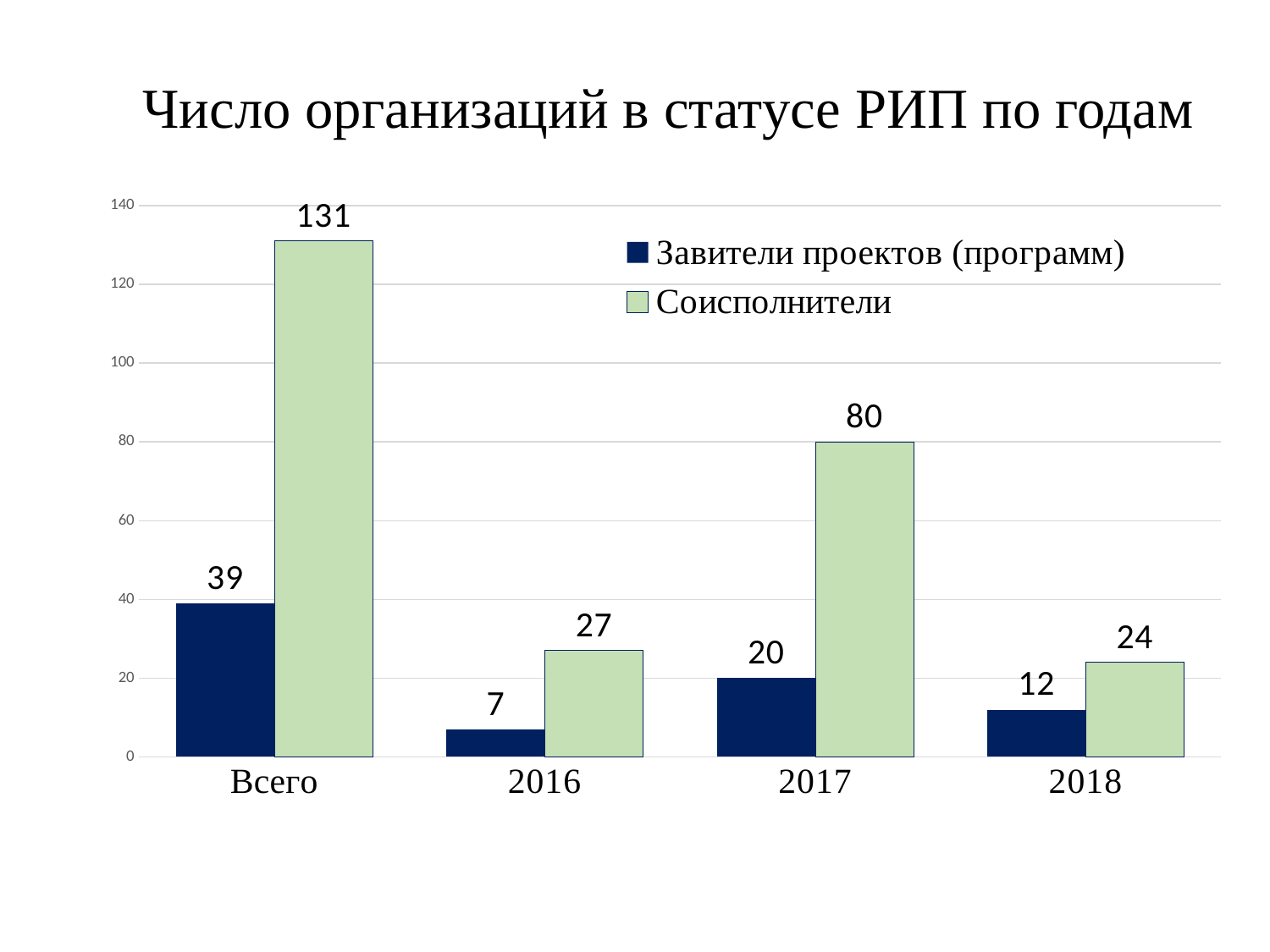
What is the title of the slide? Число организаций в статусе РИП по годам What kind of chart is shown on the slide? Bar chart Which category has the lowest value for Завители проектов (программ)? 2016 Which series is shown in dark blue? Завители проектов (программ) What is the value for Соисполнители in the Всего category? 131 Among the years 2016, 2017 and 2018, which has the highest value for Соисполнители? 2017 What is the value for Завители проектов (программ) in 2017? 20 How many series does the legend list? 2 What is the difference between Соисполнители and Завители проектов (программ) in 2017? 60 How many categories are shown on the x axis? 4 Which is larger: Соисполнители in 2016 or Соисполнители in 2018? Соисполнители in 2016 What is the value for Соисполнители in 2018? 24